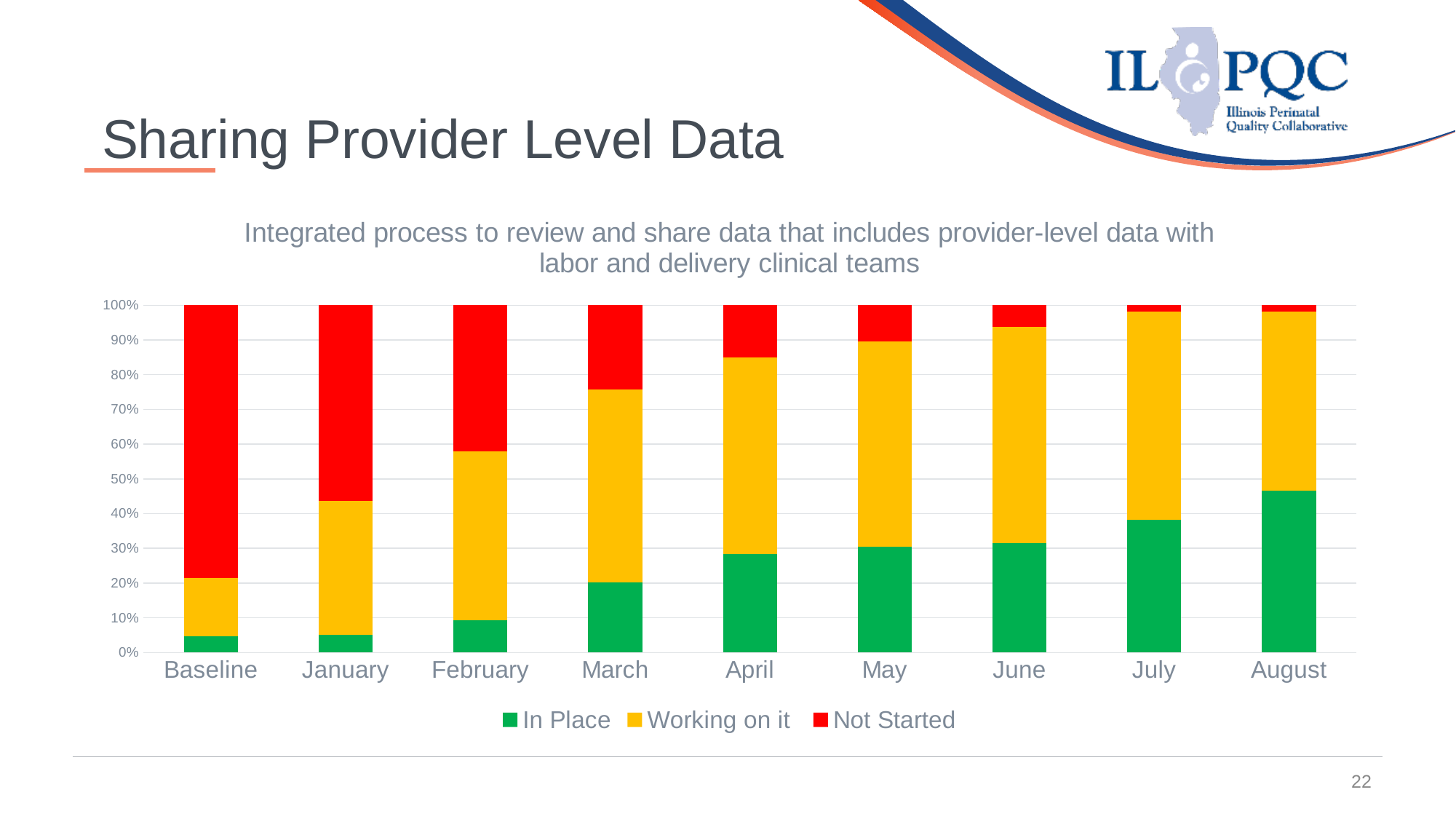
Is the 'In Place' value for March greater or less than 30%? less Does the 'In Place' share rise or fall from Baseline to August? rise What kind of chart is shown on the slide? Stacked bar chart Which has the larger 'Not Started' share, January or March? January Which has the larger 'In Place' share, April or July? July Which category has the largest 'In Place' share? August Is the 'In Place' value for August greater or less than 40%? greater How many series does the chart's legend list? 3 How many categories are shown along the x axis of the chart? 9 What are the three series listed in the chart's legend? In Place, Working on it, Not Started Which category has the largest 'Not Started' share? Baseline Is the 'Not Started' value for Baseline greater or less than 70%? greater